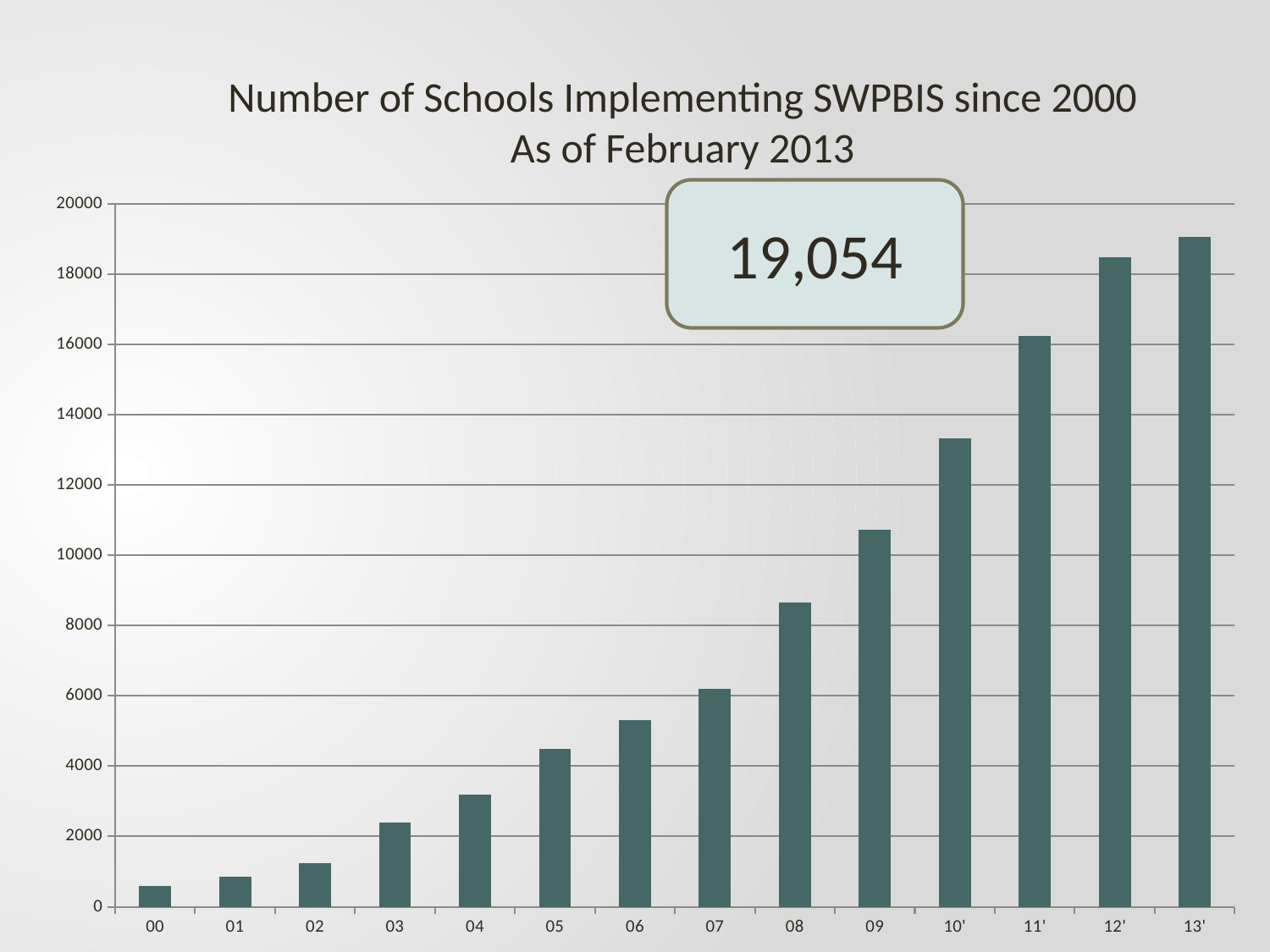
Is the value for 05 greater or less than 4000? greater Is the value for 12' greater or less than 18000? greater Do the values rise or fall from 00 to 13' along the x axis? rise Is the value for 00 greater or less than 2000? less Which year has the highest number of schools implementing SWPBIS? 13' What is the title of the chart? Number of Schools Implementing SWPBIS since 2000 As of February 2013 Which is larger, the value for 08 or the value for 07? 08 Which year has the lowest number of schools implementing SWPBIS? 00 What kind of chart is shown on the slide? bar chart What number is shown in the callout box on the chart? 19,054 How many years (categories) are shown on the x axis? 14